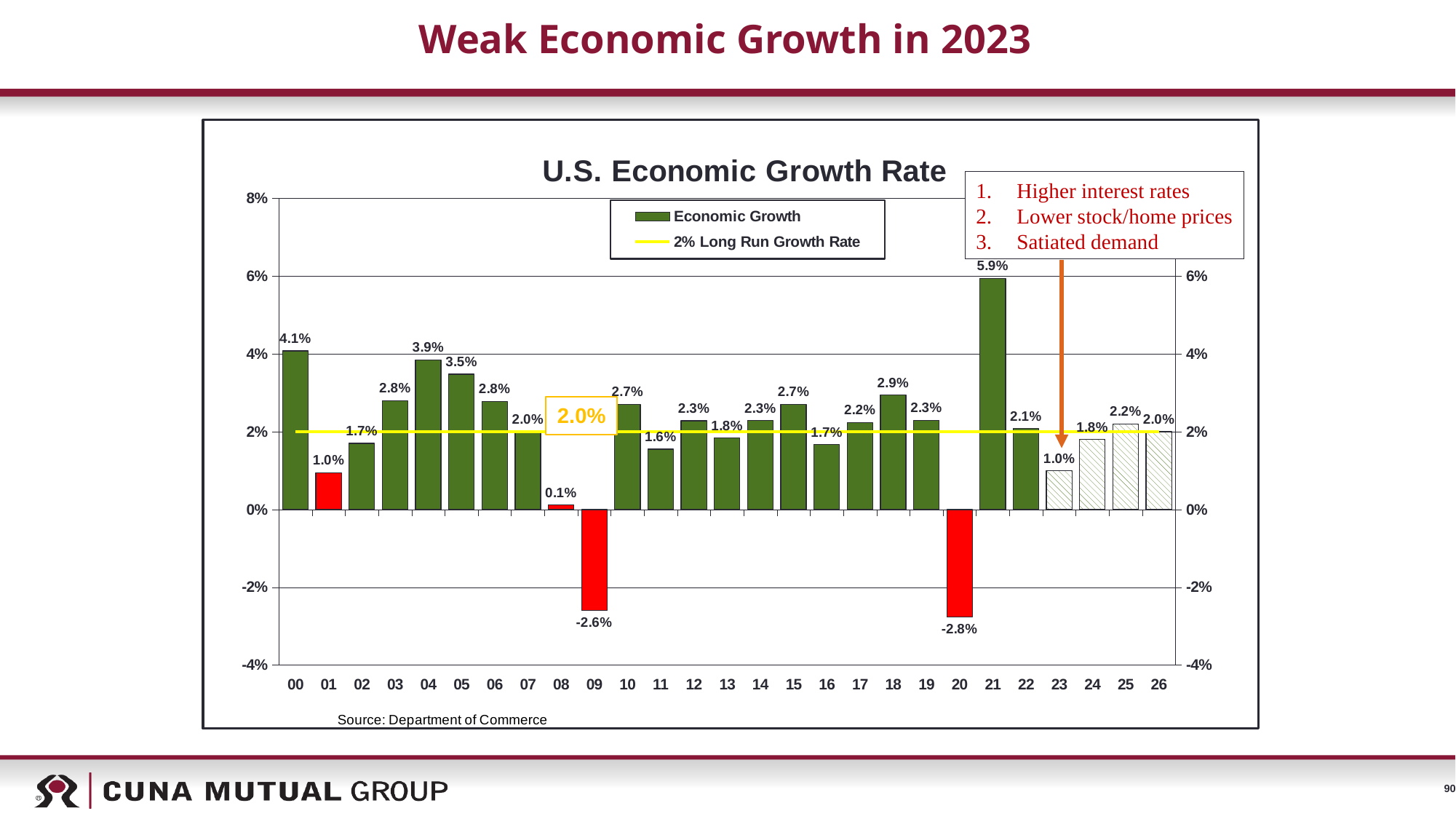
What kind of chart is used to show the economic growth rate? Bar chart Is the value for 00 greater or less than 4%? greater Which year has the highest economic growth rate? 21 Which year has the larger economic growth rate, 04 or 05? 04 What is the difference between the economic growth rate for 21 and for 22? 3.8% What is the title of the chart? U.S. Economic Growth Rate Which year has the lowest economic growth rate? 20 What is the economic growth rate shown for 21? 5.9% How many years are shown on the x axis? 27 What is the economic growth rate shown for 09? -2.6% What is the economic growth rate shown for 23? 1.0% How many series does the legend list? 2